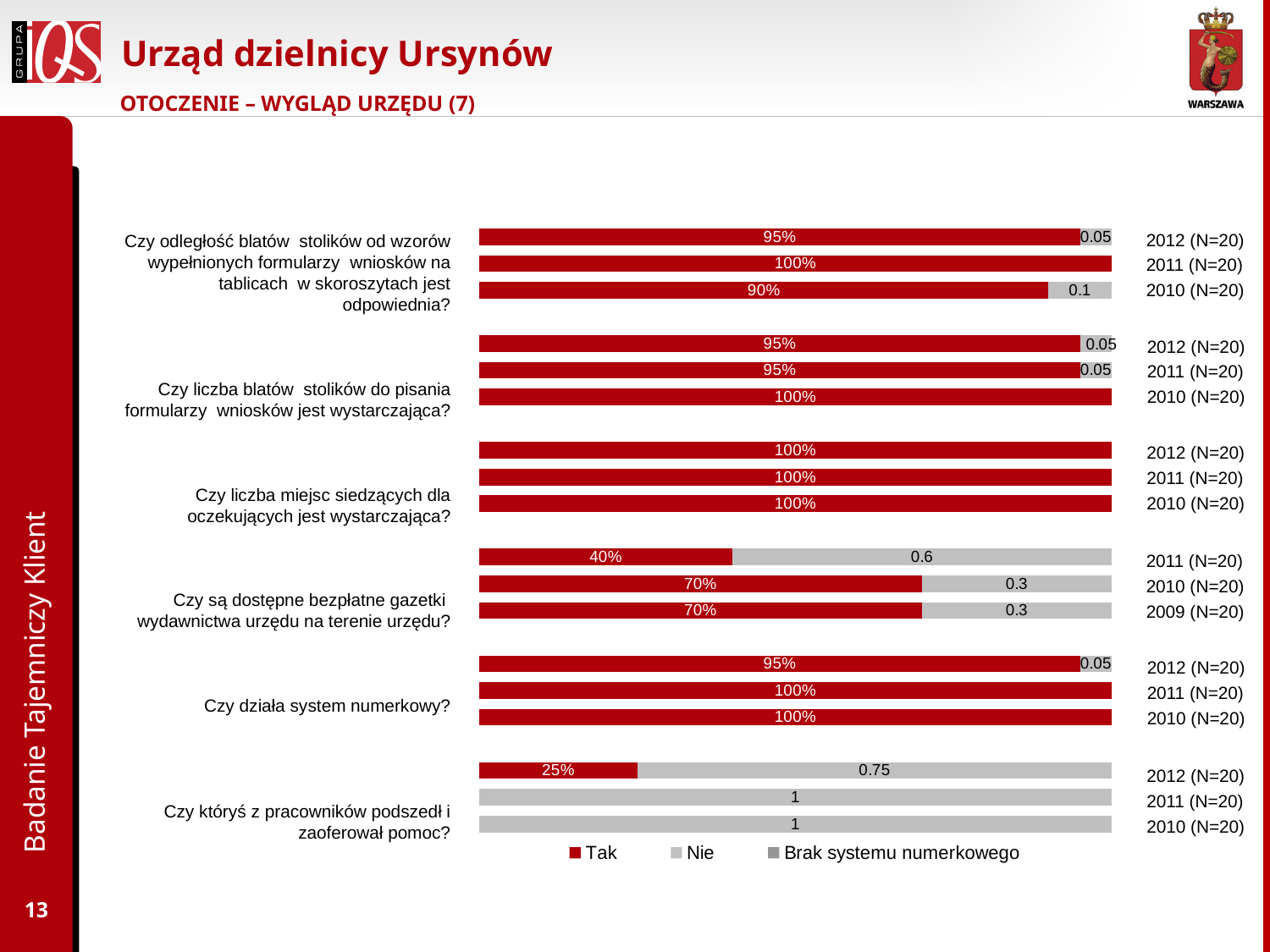
What kind of chart is shown on the slide? bar chart For 'Czy są dostępne bezpłatne gazetki wydawnictwa urzędu na terenie urzędu?', does the 'Tak' value rise or fall from 2009 to 2011? fall What is the 'Tak' value for 'Czy są dostępne bezpłatne gazetki wydawnictwa urzędu na terenie urzędu?' in 2011 (N=20)? 40% What is the 'Tak' value for 'Czy działa system numerkowy?' in 2012 (N=20)? 95% What is the 'Nie' value for 'Czy odległość blatów stolików od wzorów wypełnionych formularzy wniosków na tablicach w skoroszytach jest odpowiednia?' in 2010 (N=20)? 0.1 How many series does the legend list? 3 What are the entries in the chart legend? Tak, Nie, Brak systemu numerkowego For 'Czy są dostępne bezpłatne gazetki wydawnictwa urzędu na terenie urzędu?', which year has the larger 'Tak' value, 2011 or 2010? 2010 How many bars are plotted on the chart in total? 18 For 'Czy są dostępne bezpłatne gazetki wydawnictwa urzędu na terenie urzędu?', what is the difference in percentage points between the 'Tak' value in 2010 and in 2011? 30 What is the 'Nie' value for 'Czy któryś z pracowników podszedł i zaoferował pomoc?' in 2012 (N=20)? 0.75